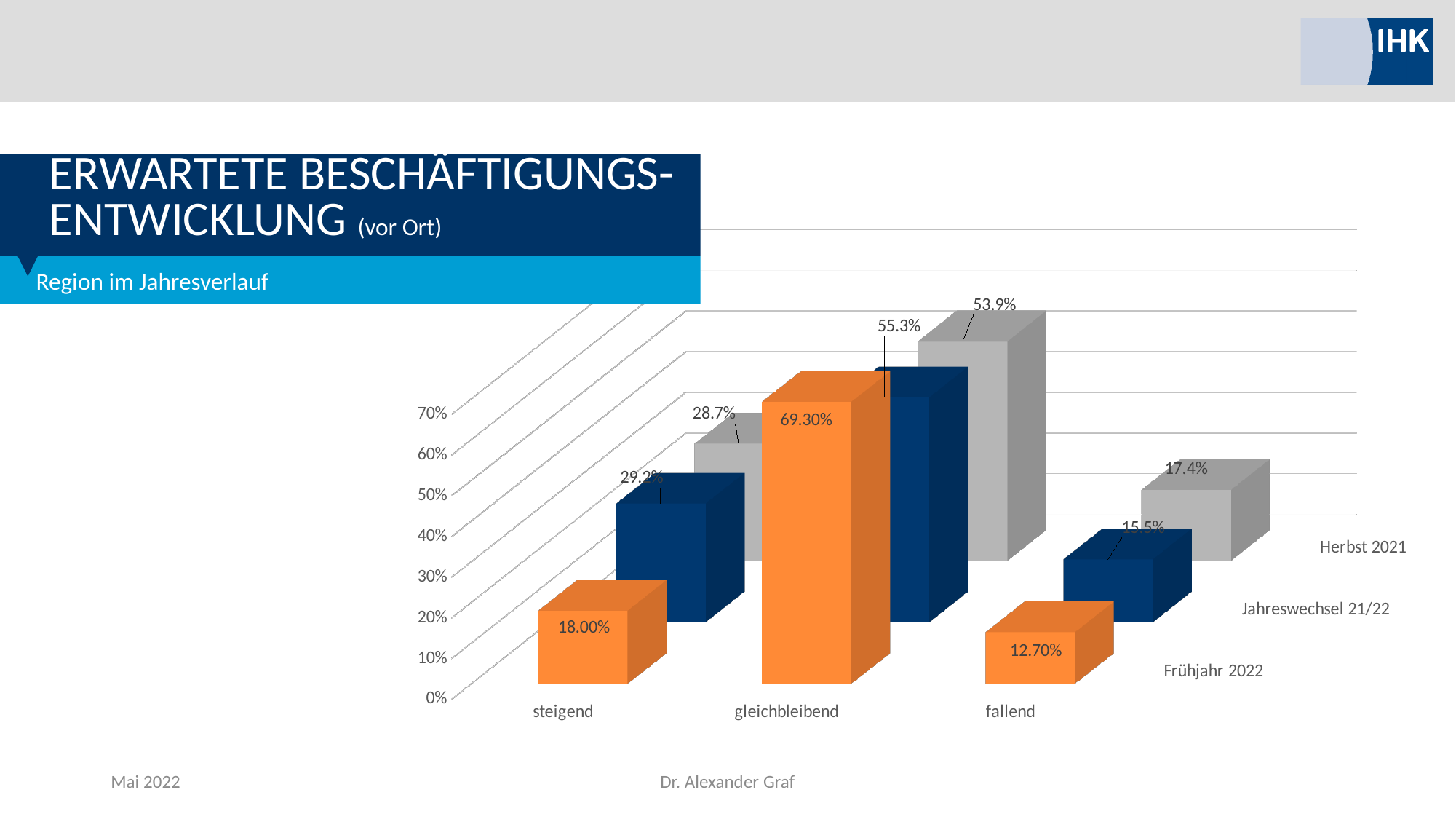
Which category has the highest value in the Frühjahr 2022 series? gleichbleibend What is the value for "gleichbleibend" in the Frühjahr 2022 series? 69.30% What is the value for "steigend" in the Jahreswechsel 21/22 series? 29.2% How many data series are plotted in the chart? 3 What colour are the bars for the Frühjahr 2022 series? orange What is the difference between the Frühjahr 2022 value for "steigend" and for "fallend"? 5.30% What kind of chart is shown on the slide? bar chart How many categories are shown on the x axis? 3 What is the value for "steigend" in the Herbst 2021 series? 28.7% Which is larger for "gleichbleibend": the Jahreswechsel 21/22 value or the Herbst 2021 value? Jahreswechsel 21/22 What is the value for "fallend" in the Herbst 2021 series? 17.4% Which category has the lowest value in the Jahreswechsel 21/22 series? fallend